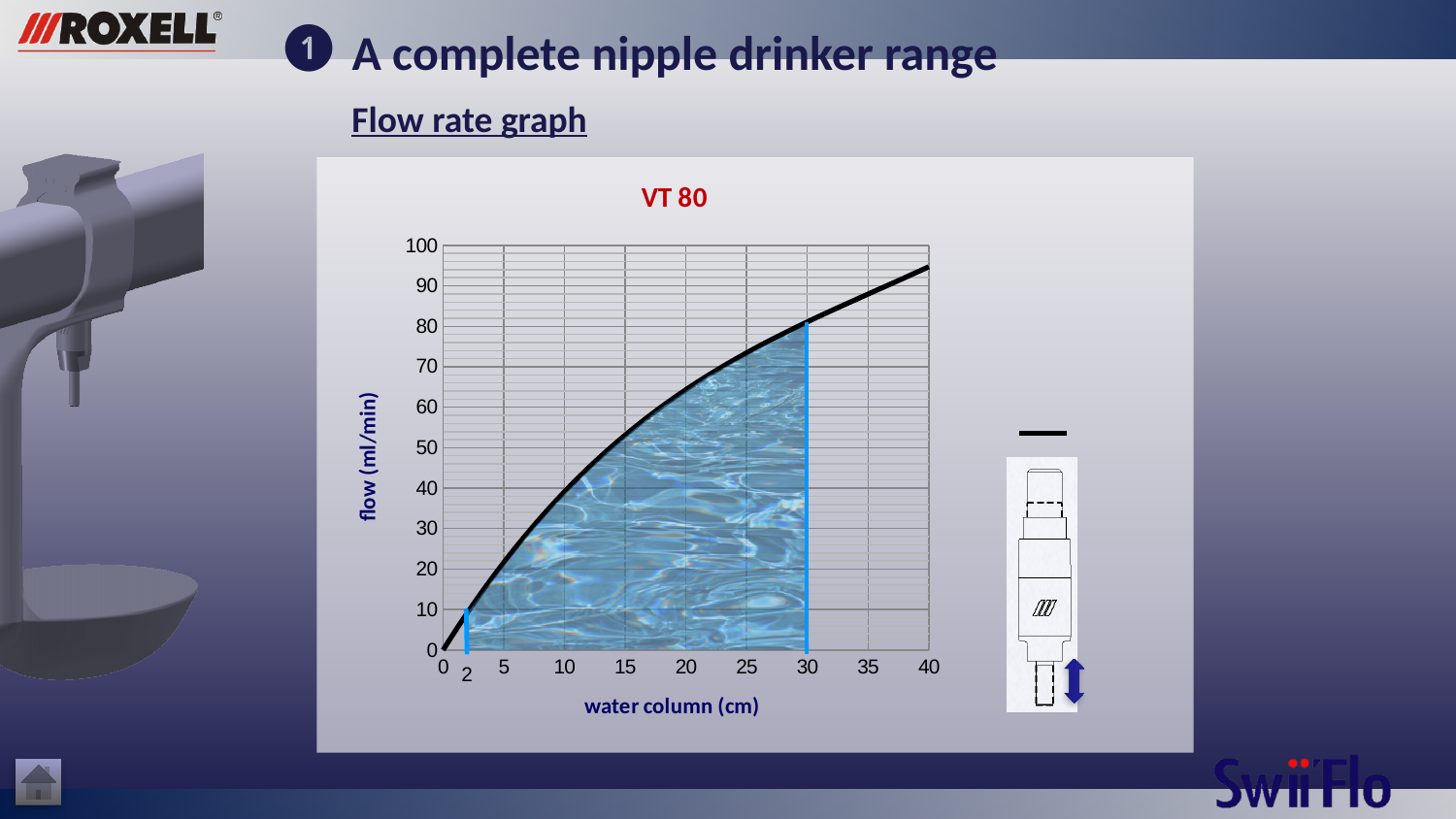
Is the flow at a water column of 10 cm greater or less than 50 ml/min? less Is the flow at a water column of 10 cm greater or less than 30 ml/min? greater Is the flow at a water column of 5 cm greater or less than 30 ml/min? less What is the label of the x axis? water column (cm) What kind of chart is shown on the slide? line chart Which water column gives the higher flow, 15 cm or 35 cm? 35 cm Does the flow rise or fall as the water column increases along the x axis? rises How many lines (series) are plotted on the chart? 1 What is the title of the chart? VT 80